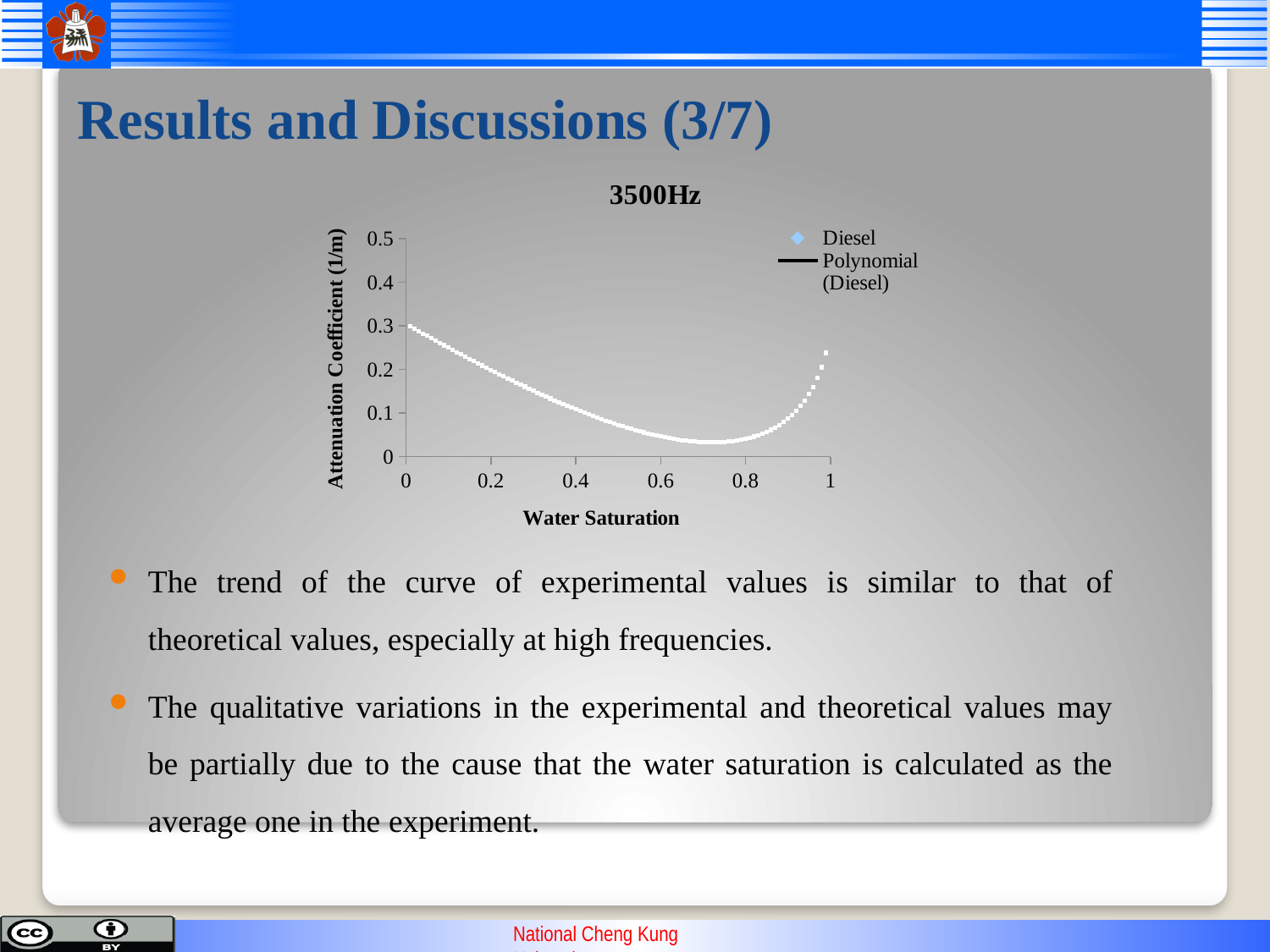
Which is larger, the attenuation coefficient at water saturation 0 or at water saturation 0.6? water saturation 0 Is the attenuation coefficient at water saturation 0 greater or less than 0.2? greater What is the label of the x axis of the chart? Water Saturation Is the attenuation coefficient at water saturation 1 greater or less than 0.1? greater How does the attenuation coefficient change as water saturation increases from 0 to 0.6? it falls Is the attenuation coefficient at water saturation 0.8 greater or less than 0.1? less How many entries does the chart legend list? 2 What kind of chart is shown on the slide? scatter chart How does the attenuation coefficient change as water saturation increases from 0.8 to 1? it rises What is the title of the chart? 3500Hz